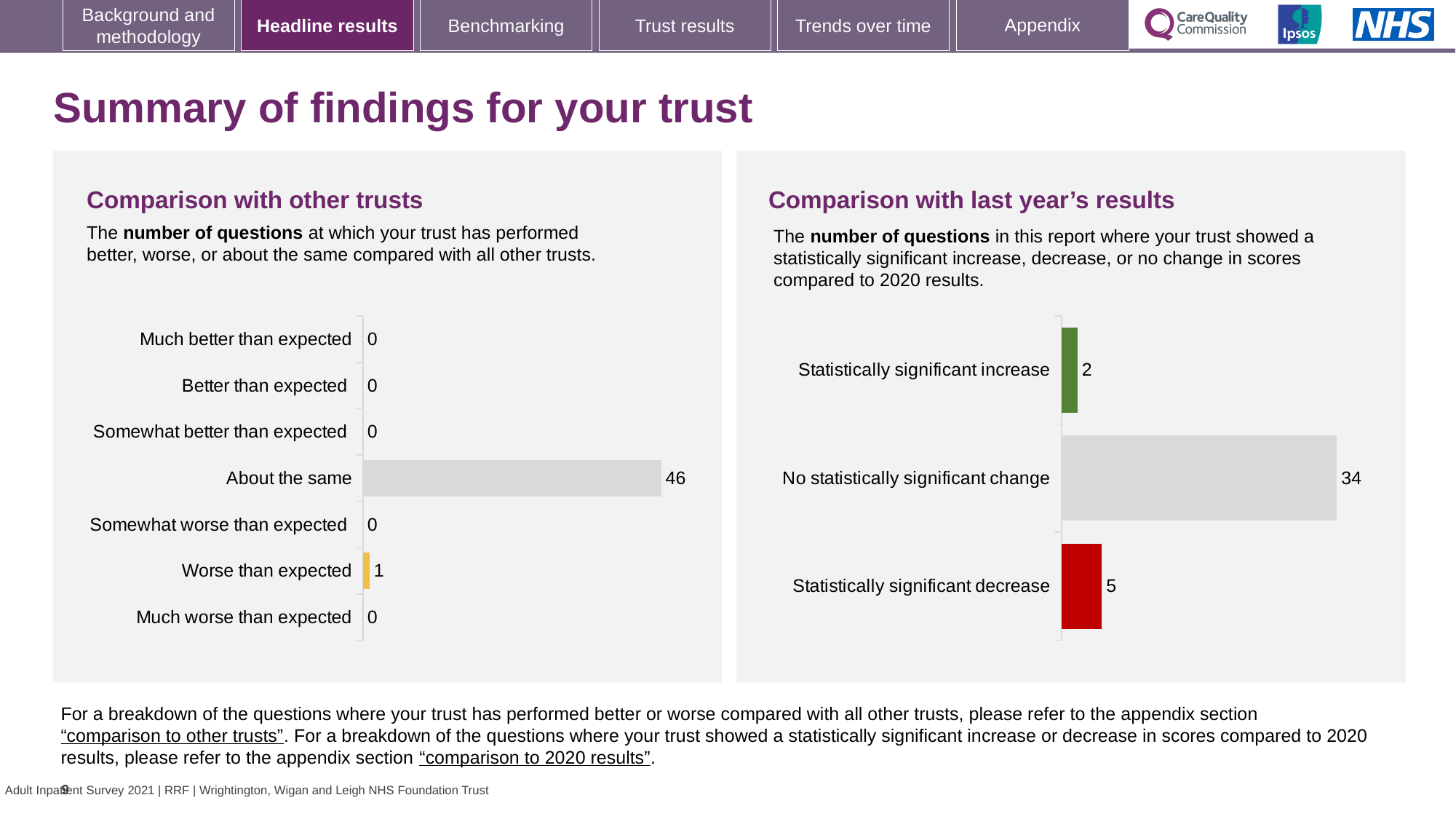
In the 'Comparison with last year's results' chart, which is larger: 'Statistically significant increase' or 'Statistically significant decrease'? Statistically significant decrease What type of chart is the 'Comparison with last year's results' chart? Bar chart In the 'Comparison with last year's results' chart, how many questions showed a statistically significant increase? 2 In the 'Comparison with other trusts' chart, what is the value for 'Much better than expected'? 0 In the 'Comparison with other trusts' chart, what is the difference between 'About the same' and 'Worse than expected'? 45 In the 'Comparison with last year's results' chart, which category has the lowest value? Statistically significant increase In the 'Comparison with other trusts' chart, how many questions are 'About the same'? 46 In the 'Comparison with other trusts' chart, how many categories are shown? 7 In the 'Comparison with other trusts' chart, which category has the highest value? About the same In the 'Comparison with other trusts' chart, how many questions are 'Worse than expected'? 1 In the 'Comparison with last year's results' chart, what is the difference between 'No statistically significant change' and 'Statistically significant decrease'? 29 In the 'Comparison with last year's results' chart, how many questions showed a statistically significant decrease? 5